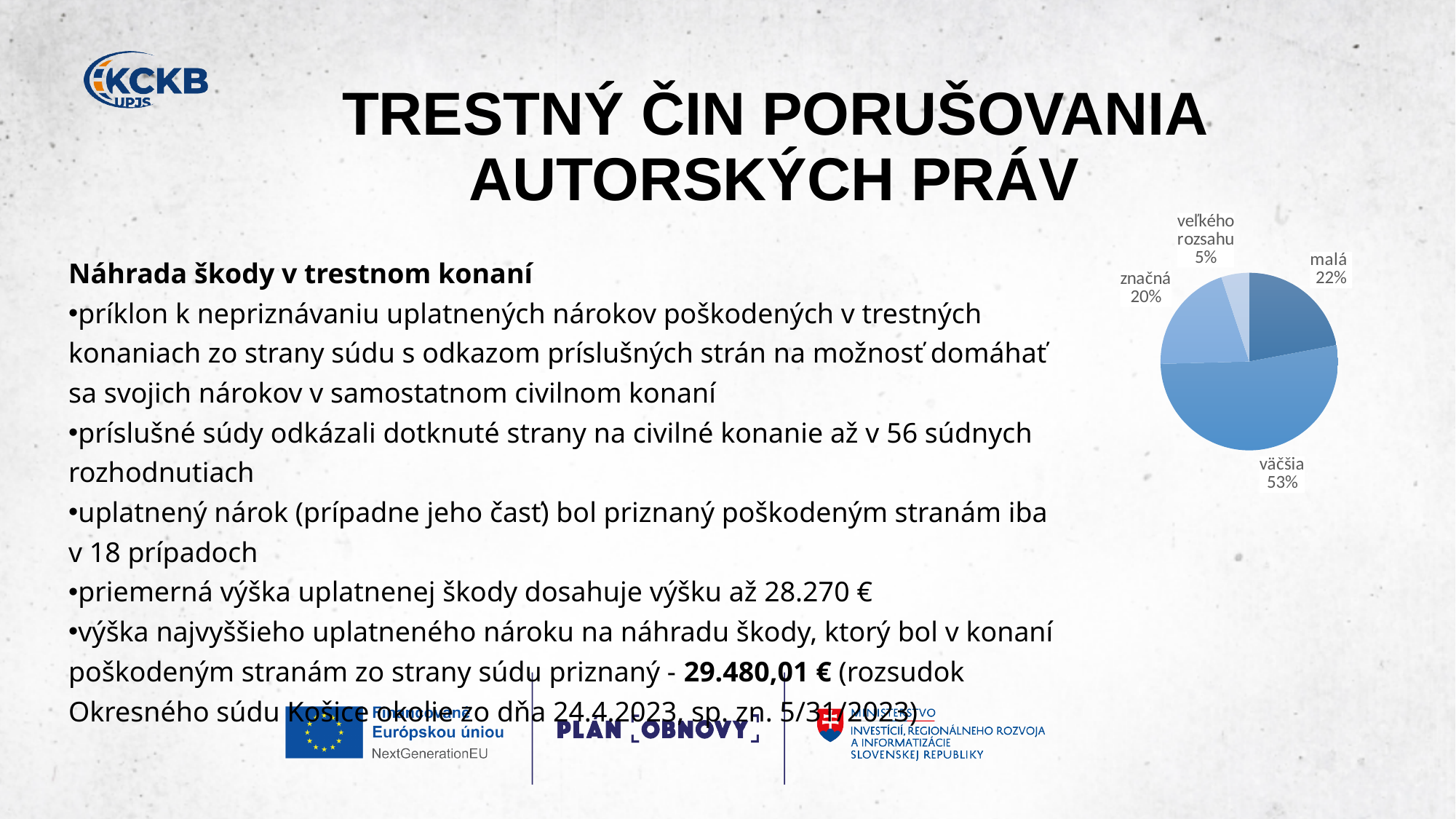
Which slice of the pie chart is the smallest? veľkého rozsahu What share of the pie does the 'veľkého rozsahu' slice represent? 5% Which slice of the pie chart is the largest? väčšia What share of the pie does the 'väčšia' slice represent? 53% How many slices does the pie chart have? 4 What share of the pie does the 'malá' slice represent? 22% What is the difference in percentage points between the 'väčšia' and 'malá' slices? 31 Which slice is larger, 'malá' or 'veľkého rozsahu'? malá What is the difference in percentage points between the 'značná' and 'veľkého rozsahu' slices? 15 Which slice is larger, 'väčšia' or 'značná'? väčšia What kind of chart is shown on the slide? pie chart